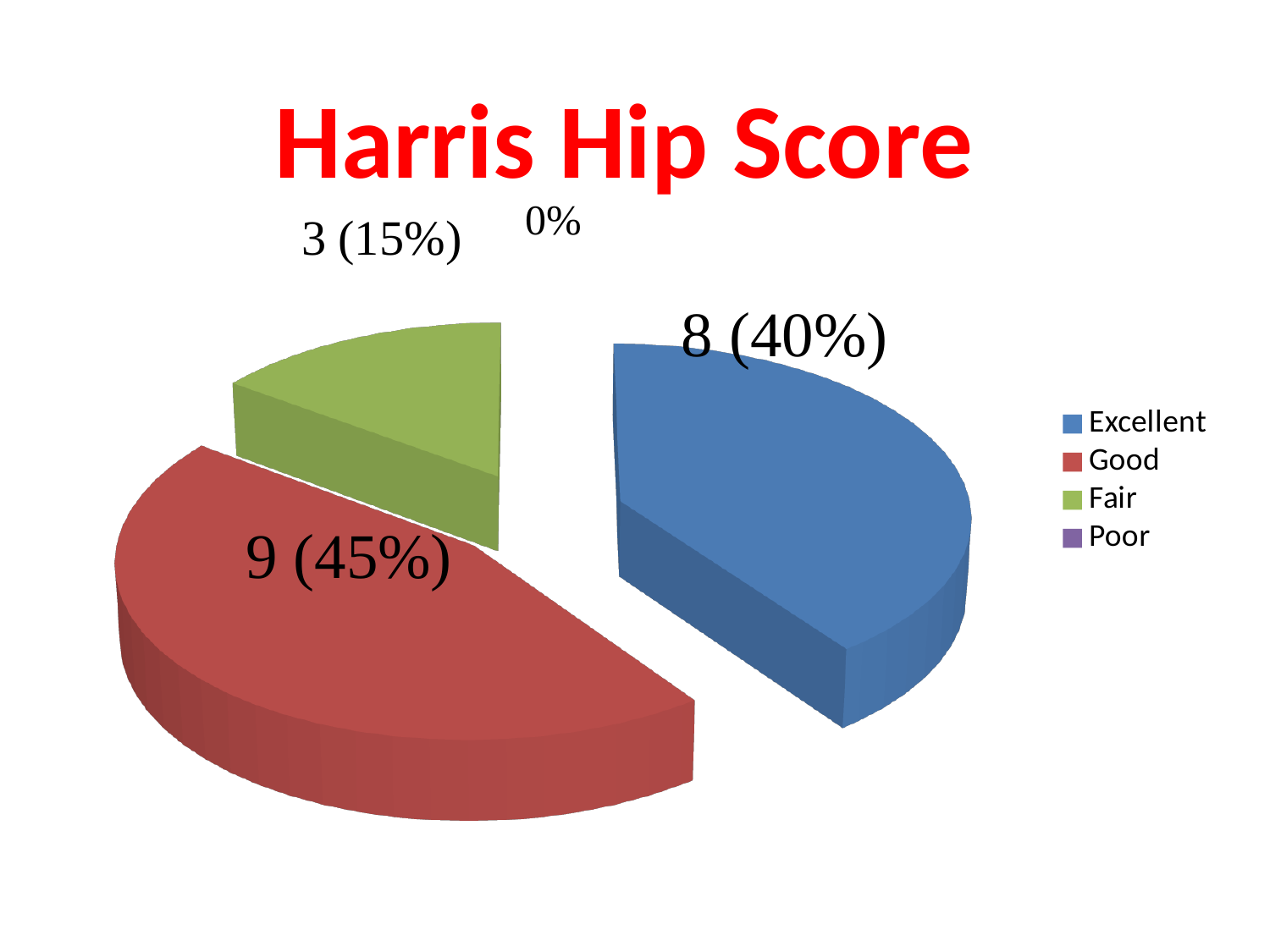
What kind of chart is shown on the slide? pie chart Which category has the largest slice of the pie? Good What share of the pie does the Excellent slice represent? 40% Which category has the smallest share of the pie? Poor Which is larger, the Excellent slice or the Fair slice? Excellent What is the data label for the Excellent slice? 8 (40%) What percentage is shown for the Poor category? 0% How many categories does the legend list? 4 What is the data label for the Fair slice? 3 (15%) What is the title of the chart? Harris Hip Score What is the data label for the Good slice? 9 (45%) How many more cases are in the Good category than in the Fair category? 6